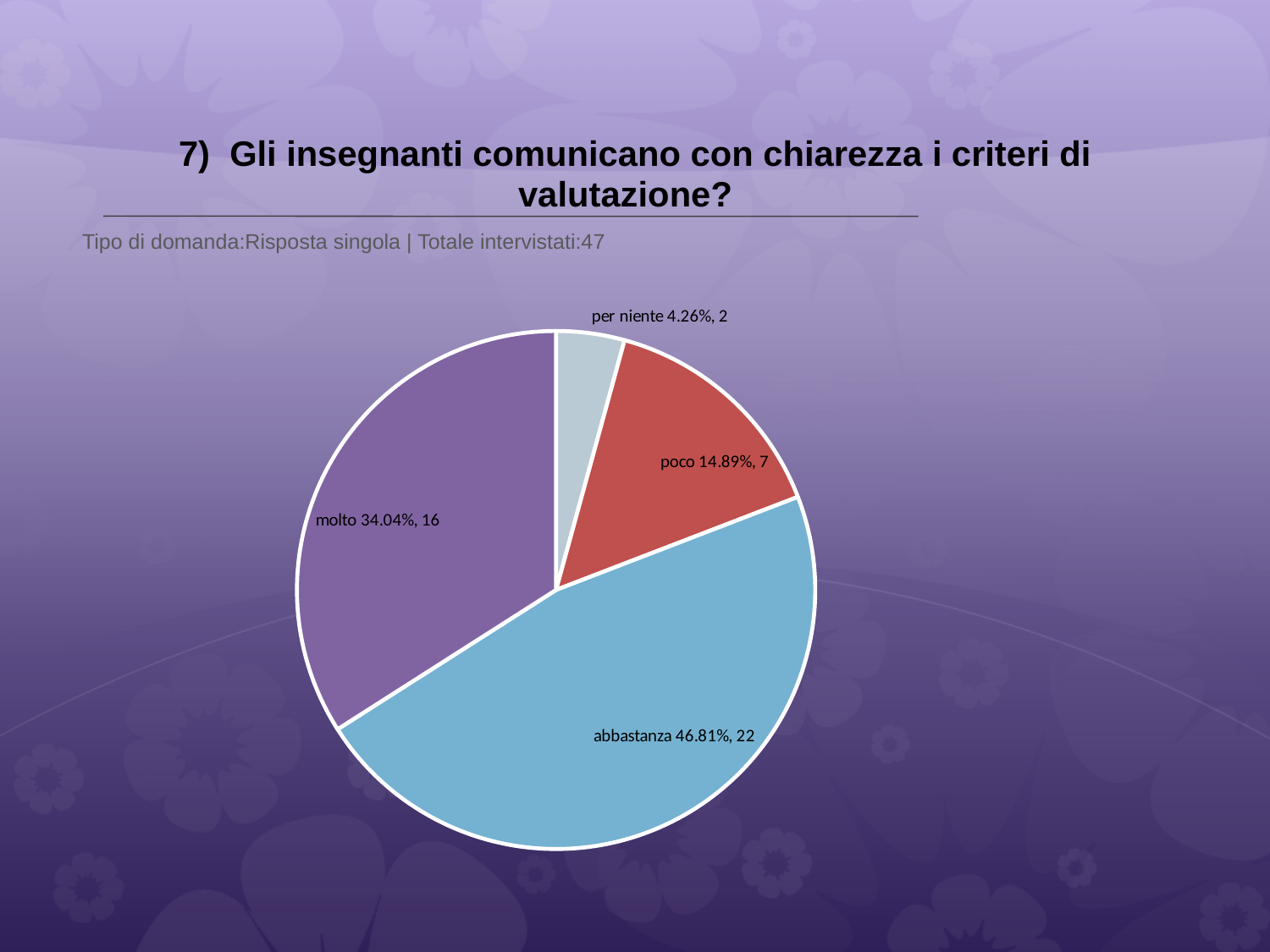
Which response category has the largest slice? abbastanza What percentage share does the 'per niente' slice have? 4.26% What percentage share does the 'abbastanza' slice have? 46.81% Which has more respondents, 'poco' or 'per niente'? poco What is the total number of respondents shown in the subtitle? 47 Which response category has the smallest slice? per niente How many respondents answered 'molto'? 16 How many slices does the pie chart have? 4 What colour is the 'abbastanza' slice? blue What kind of chart is shown on the slide? pie chart What is the difference in respondent count between 'abbastanza' and 'molto'? 6 How many respondents answered 'poco'? 7